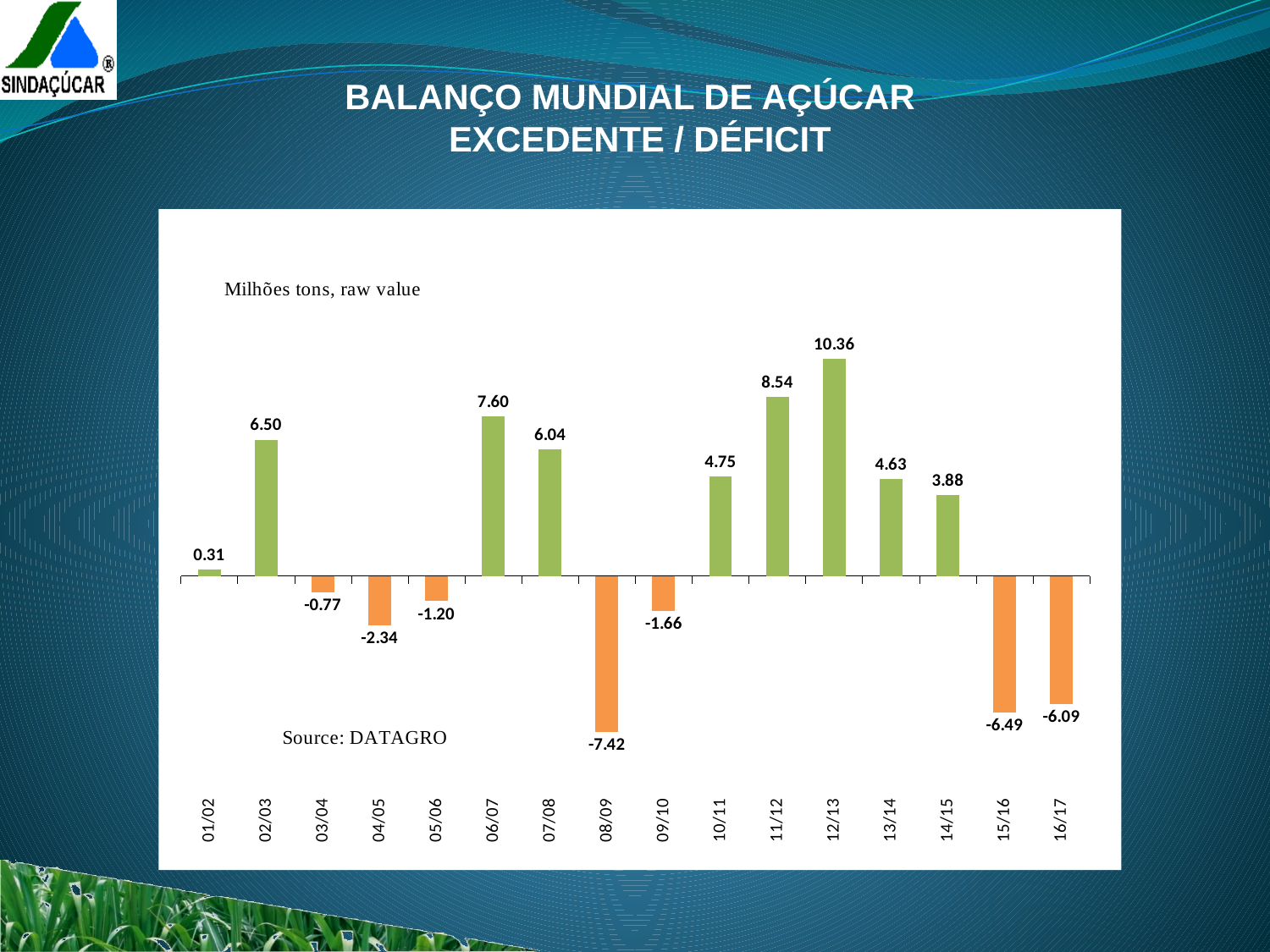
What is the value for 12/13? 10.36 What is the difference between the values for 12/13 and 11/12? 1.82 Which season has the lowest value? 08/09 How many seasons are shown on the x axis? 16 What is the source cited for the chart? DATAGRO Which season has the highest value? 12/13 What is the value for 01/02? 0.31 Do the values rise or fall from 10/11 to 12/13? Rise Which is larger, the value for 06/07 or the value for 07/08? 06/07 What is the value for 08/09? -7.42 What unit is stated for the values in the chart? Milhões tons, raw value What kind of chart is shown on the slide? Bar chart